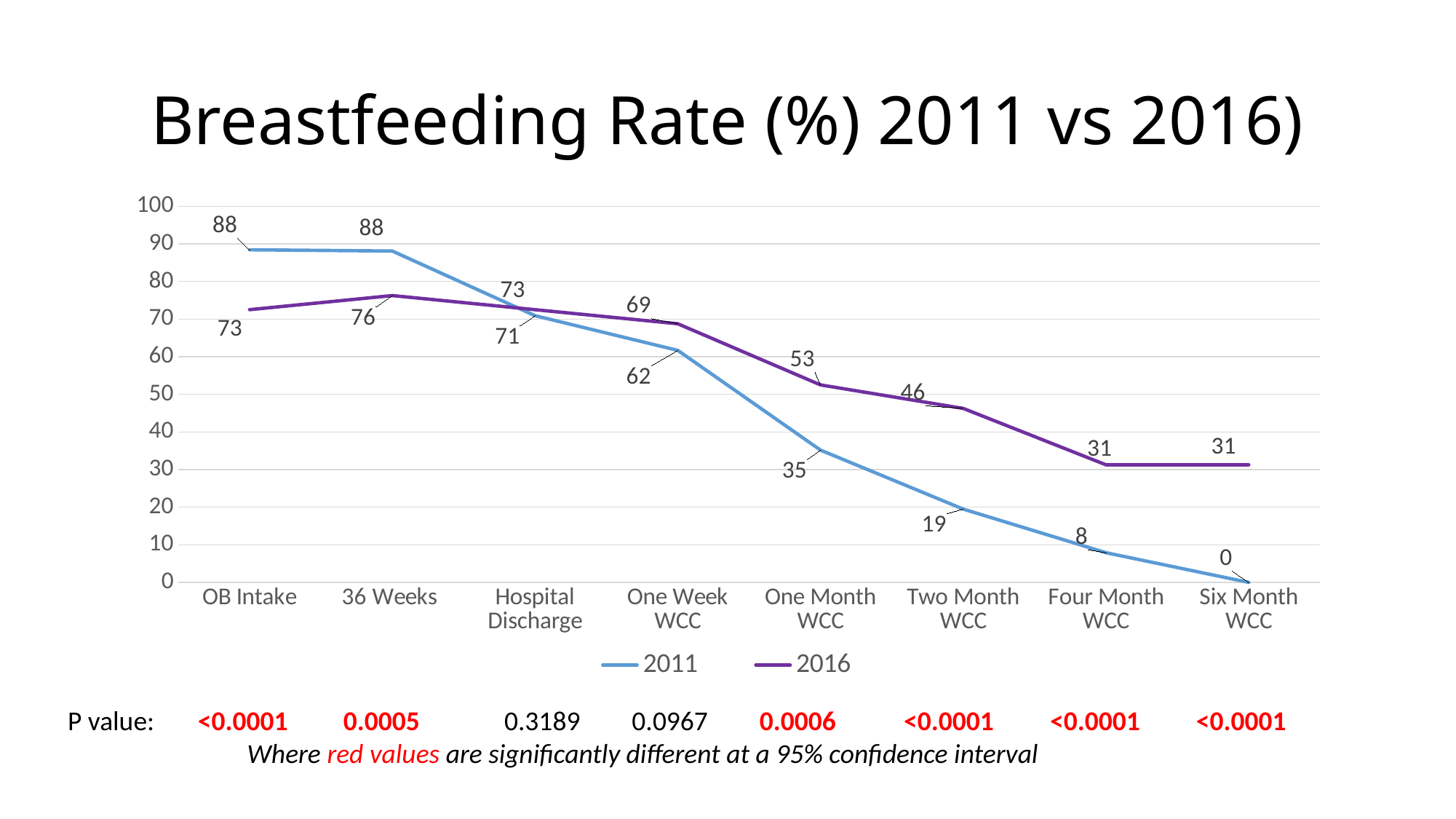
Which colour is used for the 2016 series? purple How many categories are shown on the x axis? 8 At which category is the 2016 series highest? 36 Weeks Which series has the larger value at OB Intake, 2011 or 2016? 2011 Does the 2011 series rise or fall from Hospital Discharge to Six Month WCC? fall At which category is the 2011 series lowest? Six Month WCC What is the 2011 value at Six Month WCC? 0 What type of chart is shown on the slide? line chart What is the difference between the 2016 and 2011 values at Four Month WCC? 23 What is the 2011 value at One Month WCC? 35 How many series does the legend list? 2 What is the 2016 value at Two Month WCC? 46